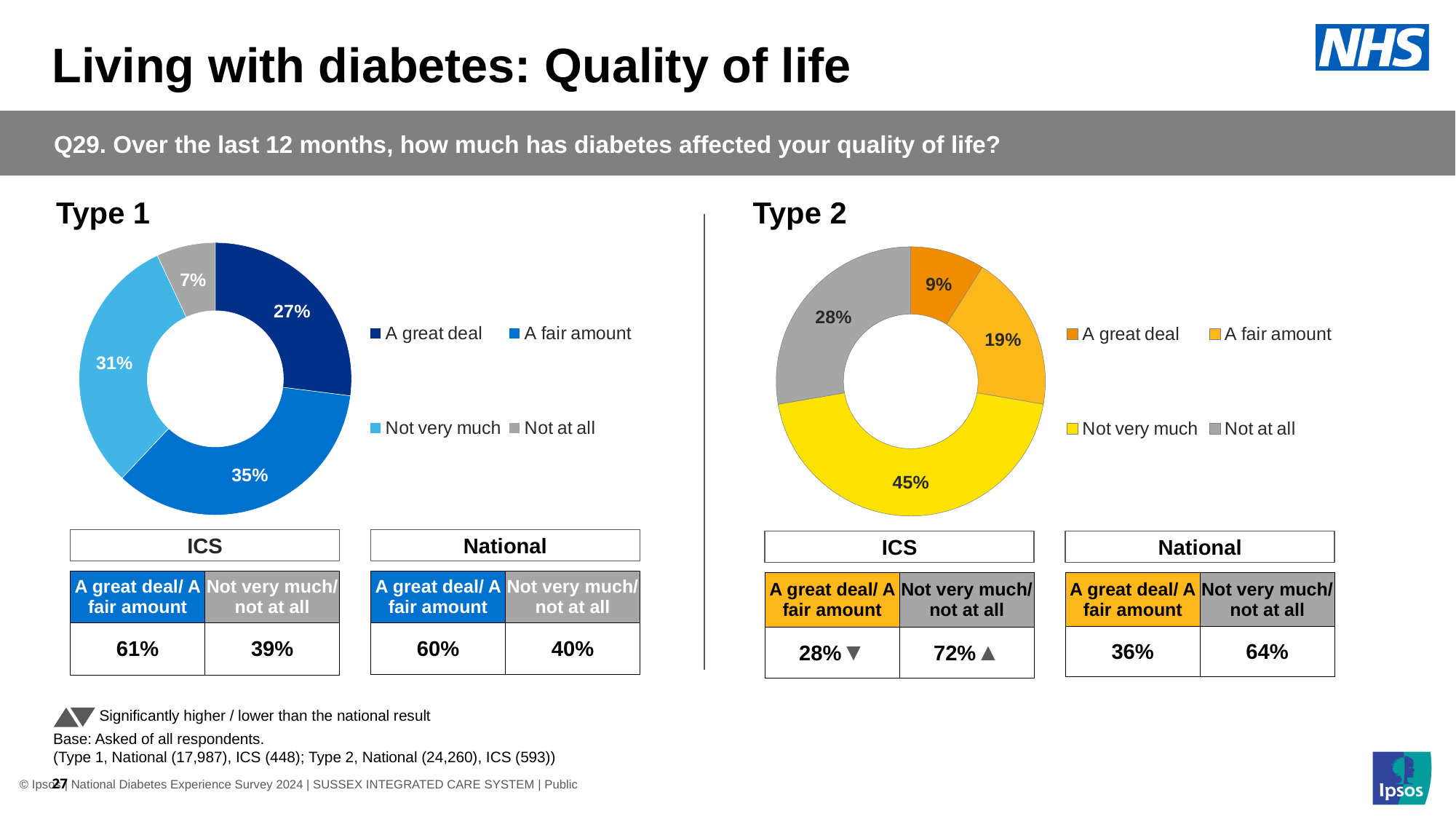
How many categories does the Type 2 chart show? 4 In the Type 1 chart, what is the difference between 'A fair amount' and 'Not very much'? 4 percentage points Which is larger: 'A great deal' in the Type 1 chart or 'A great deal' in the Type 2 chart? Type 1 In the Type 2 chart, what is the difference between 'Not very much' and 'Not at all'? 17 percentage points In the Type 2 chart, what colour represents 'Not very much'? Yellow In the Type 2 chart, which category has the smallest share? A great deal In the Type 1 chart, what is the value for 'Not at all'? 7% What kind of chart is used for Type 1? Donut (pie) chart In the Type 1 chart, which category has the largest share? A fair amount In the Type 2 chart, what percentage said 'A fair amount'? 19% In the Type 1 chart, what percentage of respondents said diabetes affected their quality of life 'A great deal'? 27% In the Type 2 chart, what is the value for 'Not very much'? 45%